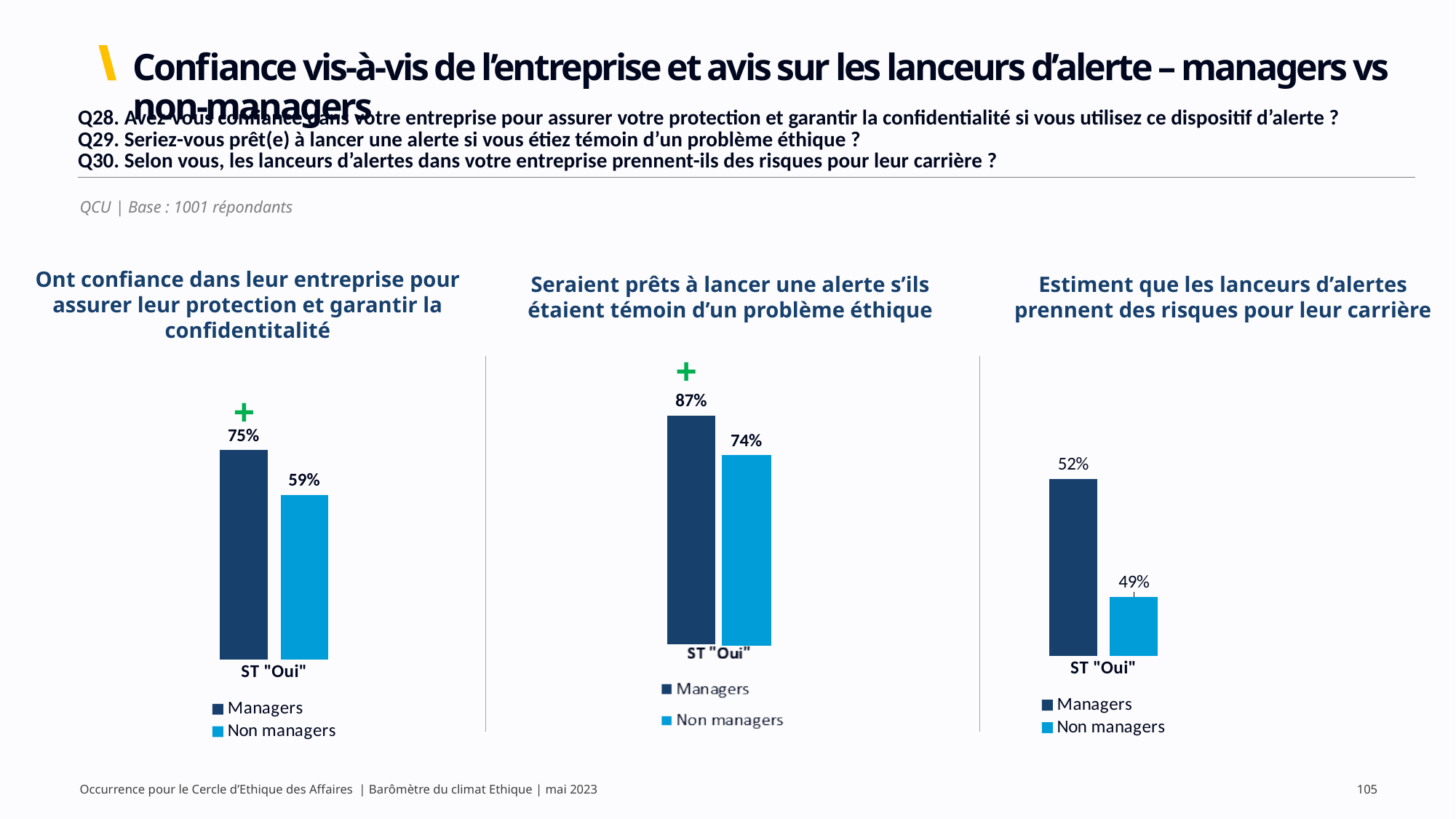
In the right chart (Estiment que les lanceurs d'alertes prennent des risques...), what is the value for Non managers? 49% In the middle chart (Seraient prêts à lancer une alerte...), what is the difference between the Managers and Non managers values? 13 percentage points How many series does the legend of the left chart list? 2 In the right chart (Estiment que les lanceurs d'alertes prennent des risques...), what is the value for Managers? 52% In the middle chart (Seraient prêts à lancer une alerte...), what is the value for Managers? 87% In the middle chart (Seraient prêts à lancer une alerte...), what is the value for Non managers? 74% In the left chart (Ont confiance dans leur entreprise...), what is the value for Managers? 75% In the middle chart (Seraient prêts à lancer une alerte...), which series has the highest value? Managers In the left chart (Ont confiance dans leur entreprise...), what is the value for Non managers? 59% What kind of chart is the middle chart (Seraient prêts à lancer une alerte...)? Bar chart In the right chart (Estiment que les lanceurs d'alertes prennent des risques...), which series has the higher value, Managers or Non managers? Managers In the left chart (Ont confiance dans leur entreprise...), what is the difference between the Managers and Non managers values? 16 percentage points